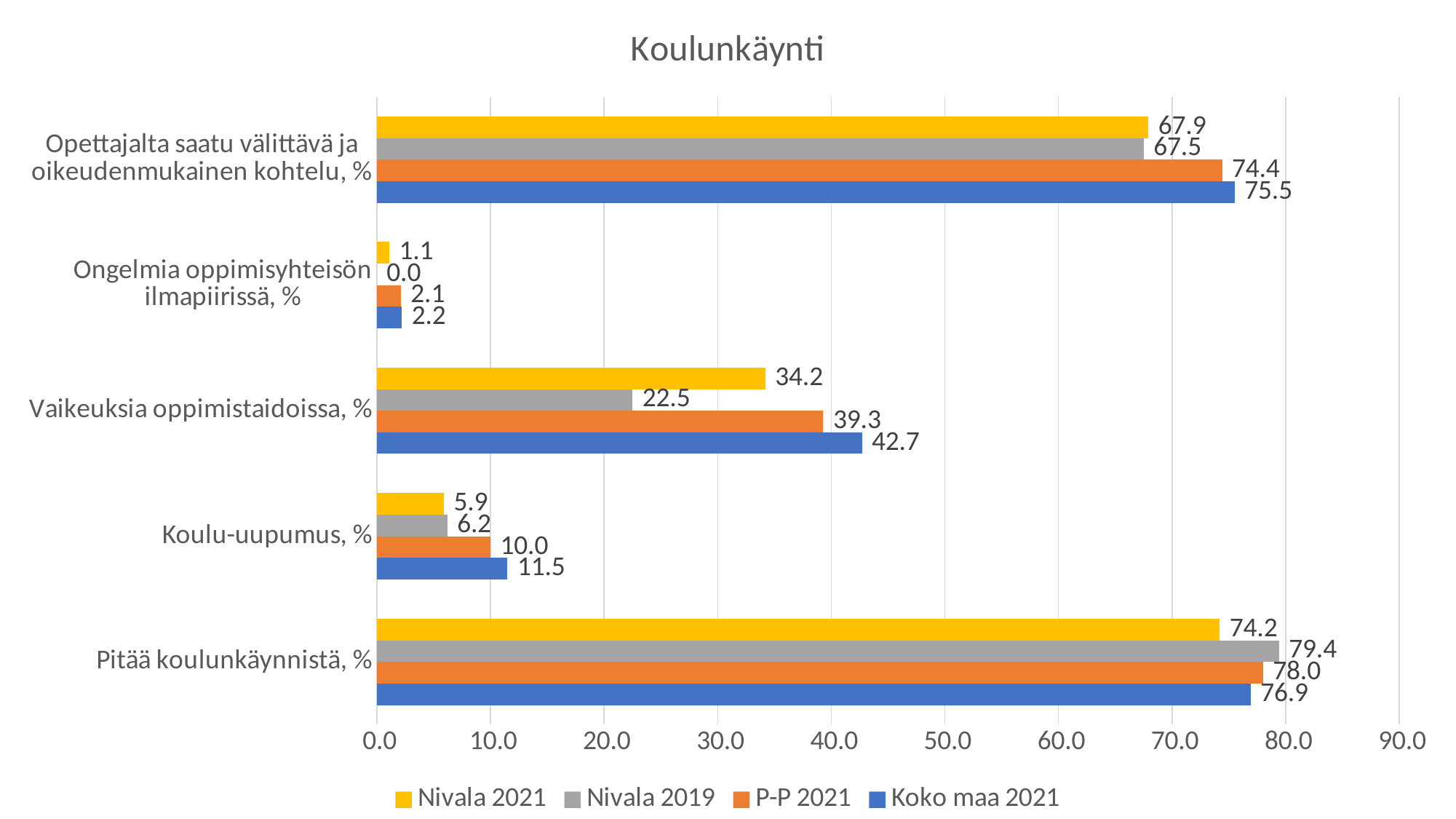
Which is larger for "Koulu-uupumus, %": the P-P 2021 value or the Nivala 2021 value? P-P 2021 What is the value for Koko maa 2021 in the category "Koulu-uupumus, %"? 11.5 Which series has the lowest value in the category "Ongelmia oppimisyhteisön ilmapiirissä, %"? Nivala 2019 How many series does the legend list? 4 What is the difference between the Nivala 2021 and Nivala 2019 values for "Vaikeuksia oppimistaidoissa, %"? 11.7 Which series has the highest value in the category "Vaikeuksia oppimistaidoissa, %"? Koko maa 2021 What is the title of the chart? Koulunkäynti What is the value for P-P 2021 in the category "Opettajalta saatu välittävä ja oikeudenmukainen kohtelu, %"? 74.4 What is the value for Nivala 2021 in the category "Vaikeuksia oppimistaidoissa, %"? 34.2 How many categories are shown on the chart? 5 What is the value for Nivala 2019 in the category "Pitää koulunkäynnistä, %"? 79.4 What kind of chart is shown on the slide? Bar chart